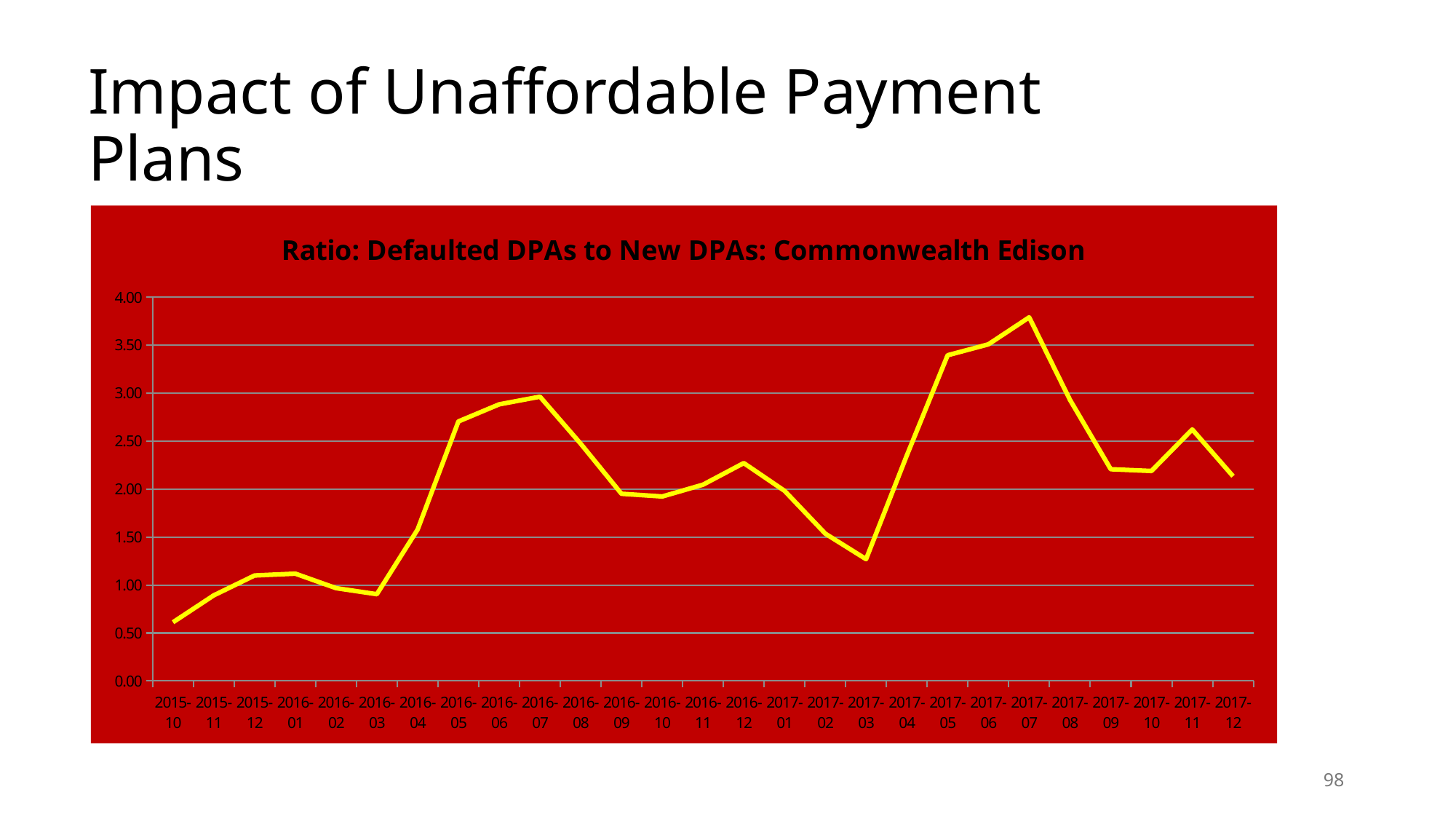
Which is larger, the value for 2017-07 or the value for 2016-07? 2017-07 Which month has the lowest ratio on the chart? 2015-10 Is the value for 2017-07 greater or less than 3.50? greater Does the ratio rise or fall from 2017-07 to 2017-09? fall What kind of chart is shown on the slide? line chart Is the value for 2015-10 greater or less than 1.00? less How many monthly data points are plotted on the chart? 27 Is the value for 2017-03 greater or less than 1.50? less What is the title of the chart? Ratio: Defaulted DPAs to New DPAs: Commonwealth Edison What colour is the plotted line on the chart? yellow Which month has the highest ratio on the chart? 2017-07